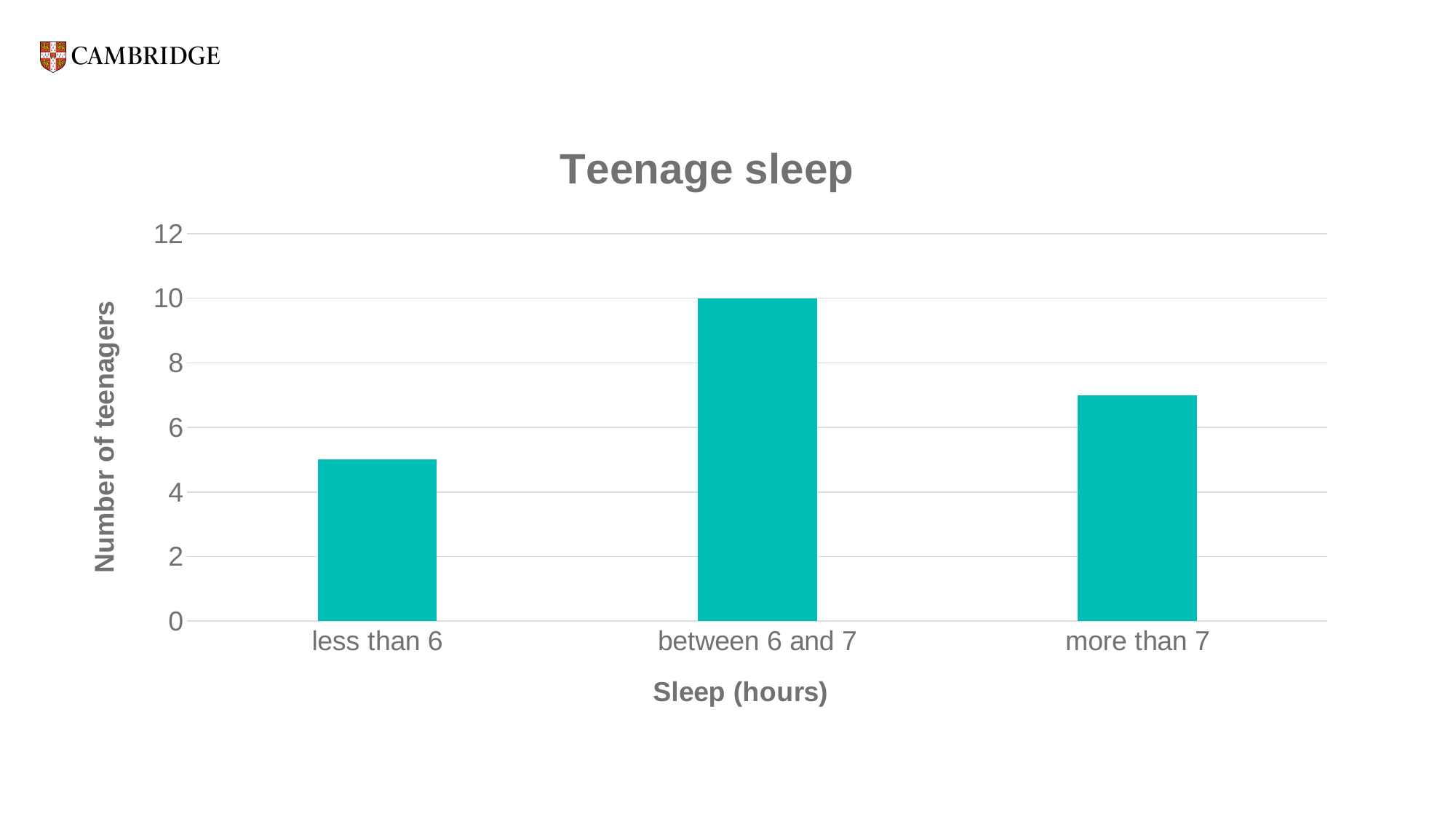
What is the number of teenagers for the 'between 6 and 7' category? 10 What kind of chart is shown on the slide? bar chart Is the value for 'more than 7' greater or less than 6? greater Which sleep category has the lowest number of teenagers? less than 6 Which has more teenagers: 'more than 7' or 'less than 6'? more than 7 Is the value for 'more than 7' greater or less than 8? less What is the title of the chart? Teenage sleep Which sleep category has the highest number of teenagers? between 6 and 7 Is the value for 'less than 6' greater or less than 6? less How many sleep categories are shown on the chart? 3 What is the label of the vertical axis? Number of teenagers